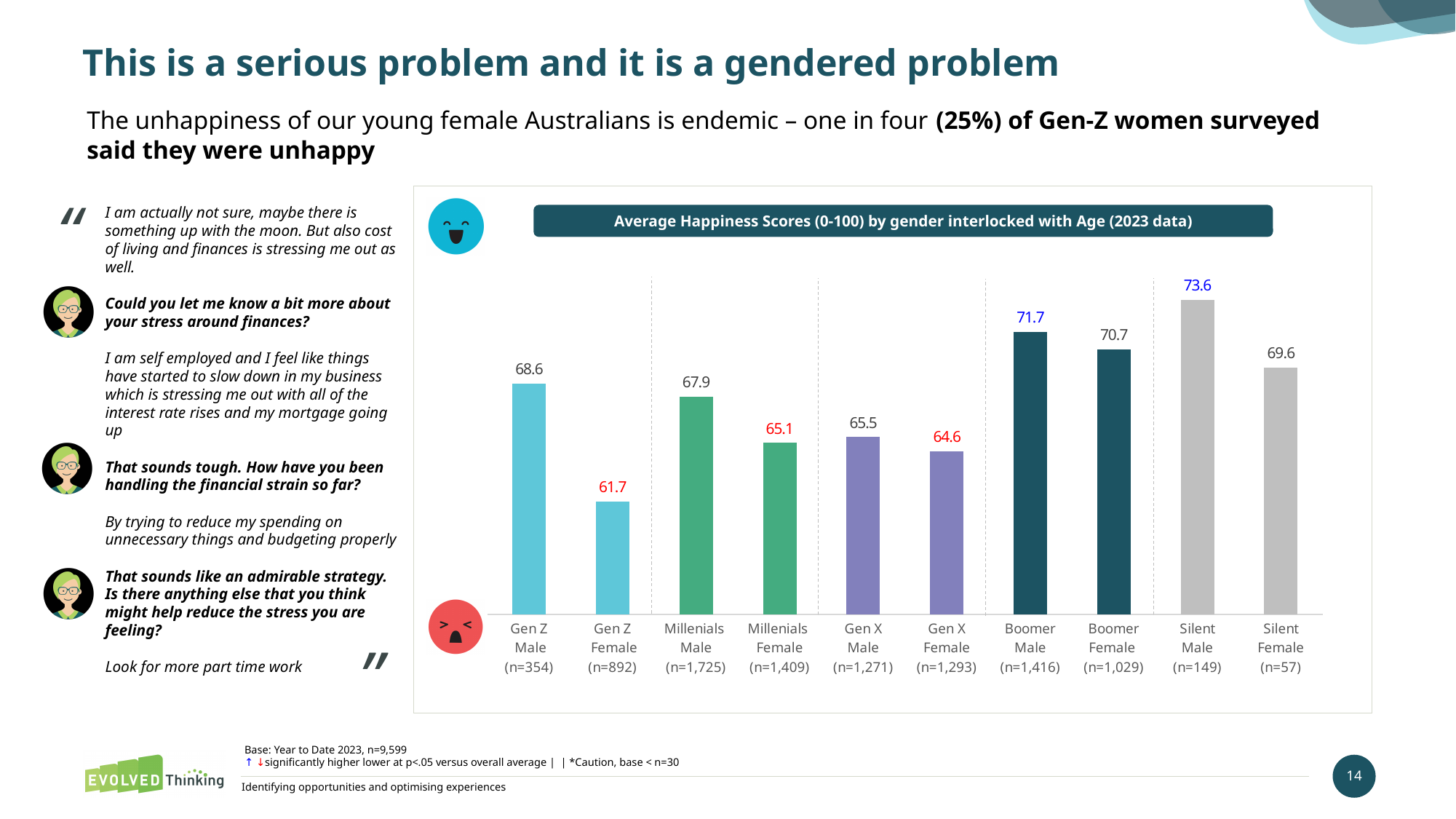
Which has a higher happiness score, Gen X Male or Gen X Female? Gen X Male What is the difference between the happiness scores of Gen Z Male and Gen Z Female? 6.9 What is the title of the chart? Average Happiness Scores (0-100) by gender interlocked with Age (2023 data) What type of chart is shown on the slide? Bar chart What is the average happiness score for Gen Z Female? 61.7 What is the average happiness score for Boomer Male? 71.7 What is the difference between the happiness scores of Silent Male and Silent Female? 4.0 Which category has the lowest average happiness score? Gen Z Female Which category has the highest average happiness score? Silent Male Which has a higher happiness score, Boomer Female or Millenials Male? Boomer Female What is the average happiness score for Millenials Female? 65.1 How many categories (bars) are shown in the chart? 10